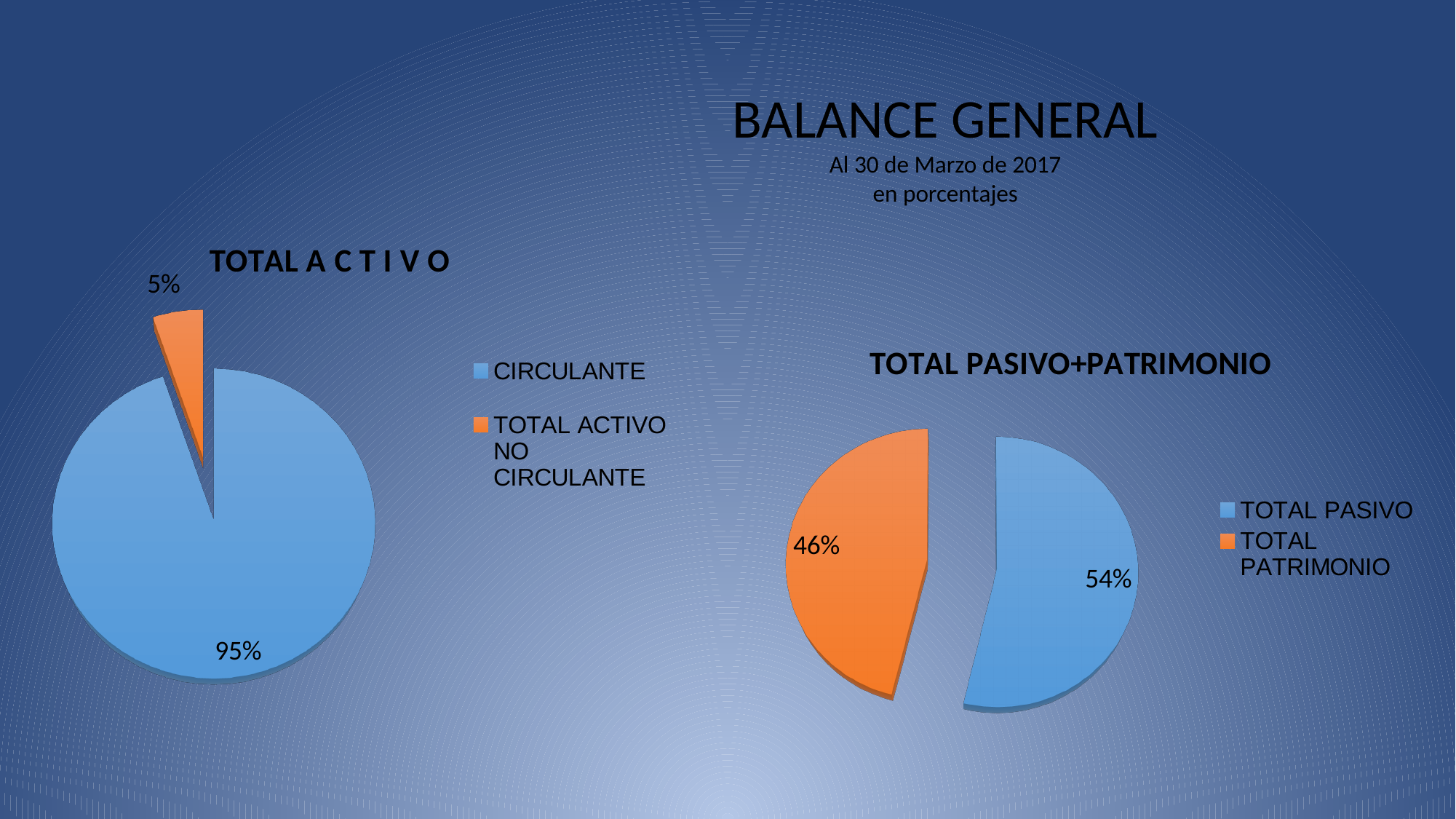
In the TOTAL PASIVO+PATRIMONIO chart, what share does TOTAL PATRIMONIO have? 46% In the TOTAL PASIVO+PATRIMONIO chart, which is larger, TOTAL PASIVO or TOTAL PATRIMONIO? TOTAL PASIVO In the TOTAL PASIVO+PATRIMONIO chart, which slice is the smallest? TOTAL PATRIMONIO In the TOTAL A C T I V O chart, what share does CIRCULANTE have? 95% In the TOTAL A C T I V O chart, what share does TOTAL ACTIVO NO CIRCULANTE have? 5% What kind of chart is the TOTAL A C T I V O chart? Pie chart In the TOTAL PASIVO+PATRIMONIO chart, what is the difference in percentage points between TOTAL PASIVO and TOTAL PATRIMONIO? 8 In the TOTAL A C T I V O chart, what is the difference in percentage points between CIRCULANTE and TOTAL ACTIVO NO CIRCULANTE? 90 In the TOTAL PASIVO+PATRIMONIO chart, what share does TOTAL PASIVO have? 54% In the TOTAL A C T I V O chart, what colour is the CIRCULANTE slice? Blue In the TOTAL A C T I V O chart, which slice is the largest? CIRCULANTE How many slices does the TOTAL PASIVO+PATRIMONIO chart have? 2